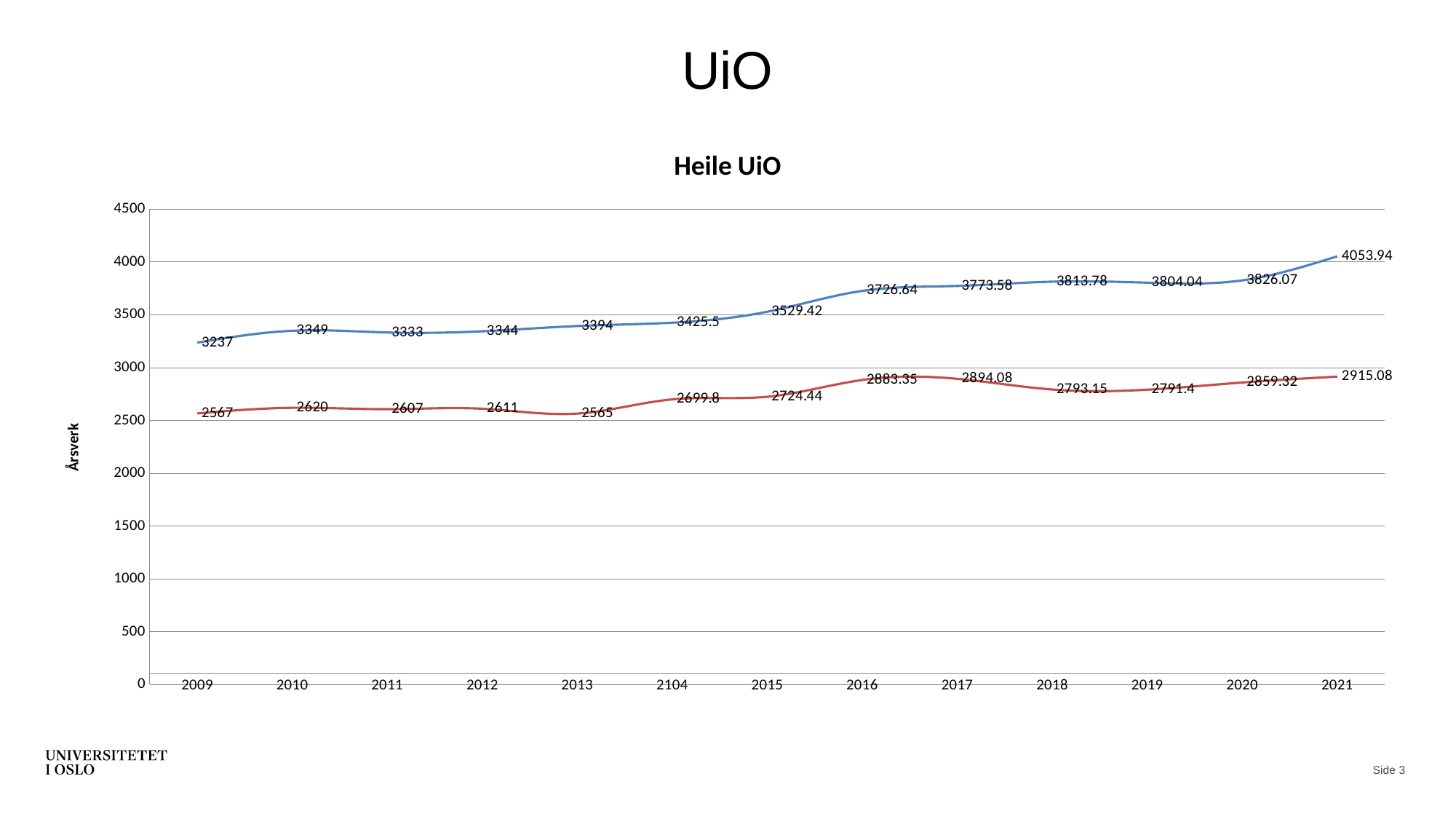
By how much did the blue line increase from 2009 to 2021? 816.94 What is the chart title? Heile UiO What is the value of the blue line in 2009? 3237 In which year does the blue line reach its highest value? 2021 Is the value of the red line in 2021 greater or less than 3000? less In which year does the blue line have its lowest value? 2009 What type of chart is shown on the slide? line chart Which is larger, the red line value in 2017 or in 2018? 2017 What is the value of the blue line in 2021? 4053.94 How many years are shown on the x axis? 13 What is the value of the red line in 2016? 2883.35 What is the difference between the blue line and the red line in 2021? 1138.86